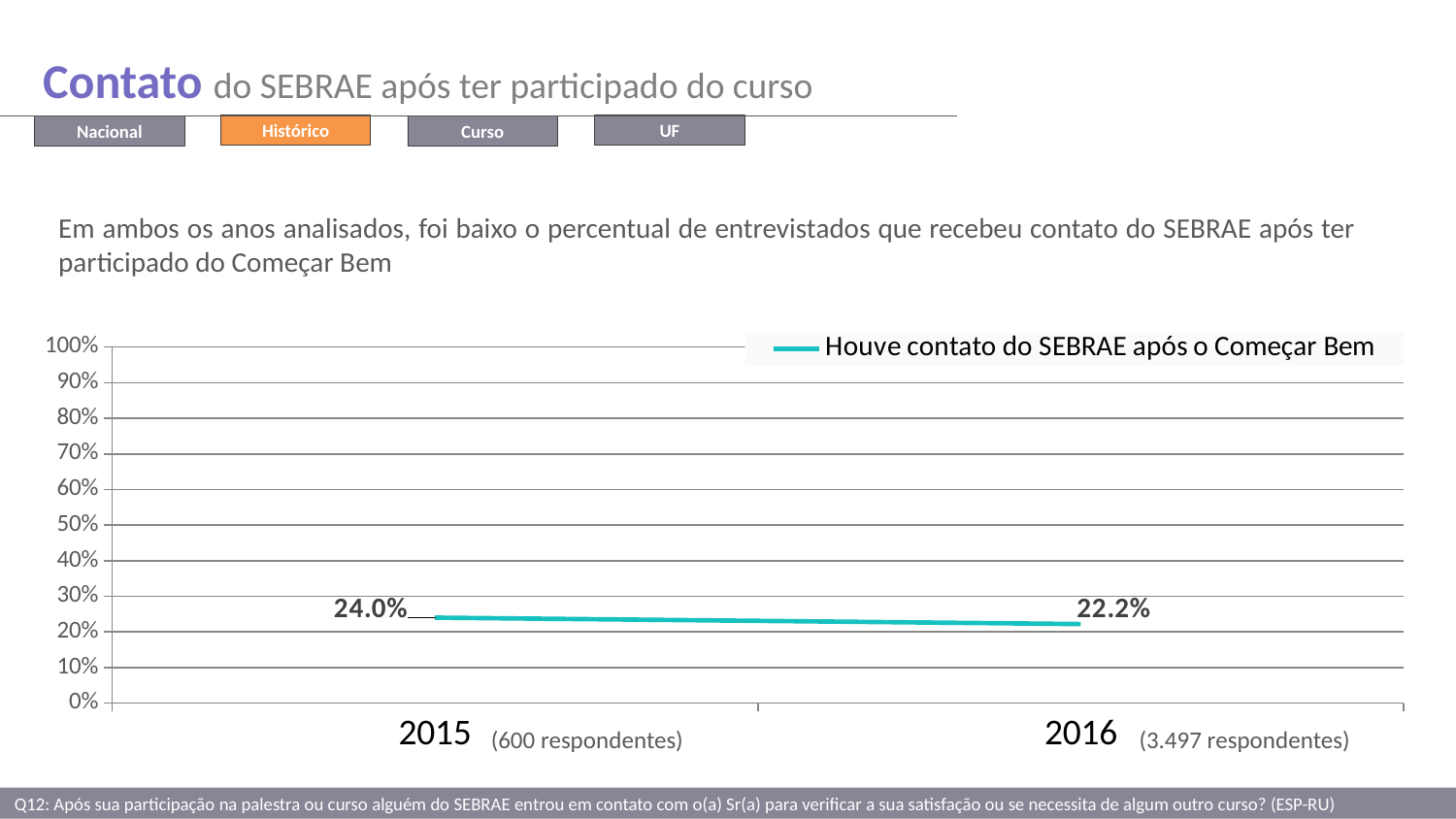
What kind of chart is shown? line chart What is the difference between the 2015 and 2016 values? 1.8% Which year has the lower value? 2016 Which year has the higher value? 2015 Is the value for 2015 larger or smaller than the value for 2016? larger How many series does the legend list? 1 What is the value for 2015? 24.0% Is the value for 2016 greater or less than 30%? less How many years are plotted on the chart? 2 What is the legend entry of the plotted series? Houve contato do SEBRAE após o Começar Bem Do the values rise or fall from 2015 to 2016? fall What is the value for 2016? 22.2%